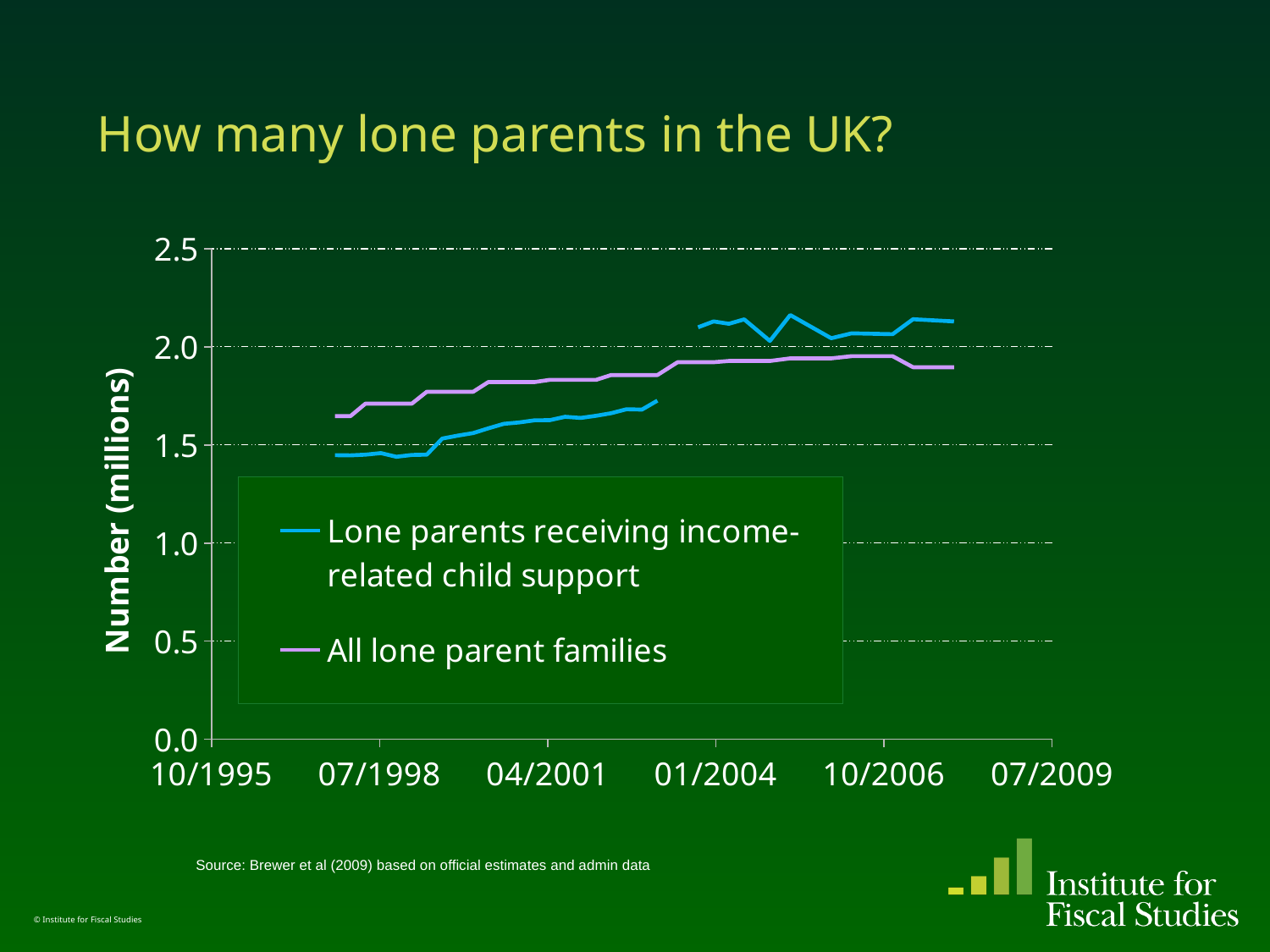
Between 07/1998 and 01/2004, does the 'All lone parent families' line rise or fall? rise Is the value for 'All lone parent families' around 07/1998 greater or less than 1.5? greater How many series does the legend list? 2 Is the value for 'Lone parents receiving income-related child support' around 04/2001 greater or less than 2.0? less Between 07/1998 and 04/2001, does the 'Lone parents receiving income-related child support' line rise or fall? rise What kind of chart is shown on the slide? Line chart What is the title of the chart on the slide? How many lone parents in the UK? Is the value for 'All lone parent families' around 01/2004 greater or less than 2.0? less Around 04/2001, which series has the higher value: 'Lone parents receiving income-related child support' or 'All lone parent families'? All lone parent families Around 10/2006, which series has the higher value: 'Lone parents receiving income-related child support' or 'All lone parent families'? Lone parents receiving income-related child support What is the label on the vertical axis of the chart? Number (millions)